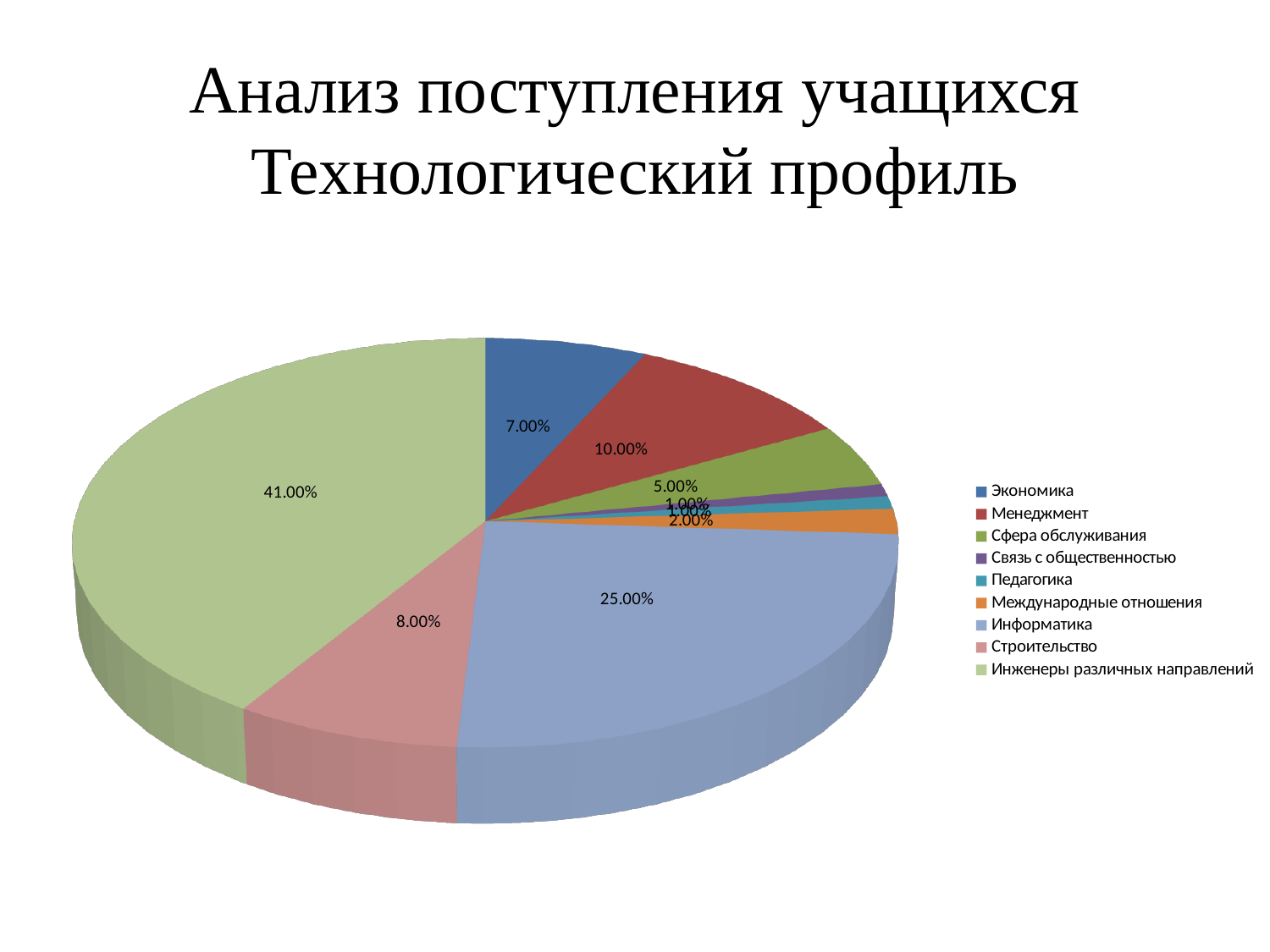
What is the value shown for Менеджмент? 10.00% What is the title of the slide containing the chart? Анализ поступления учащихся Технологический профиль Which category has the largest slice of the pie? Инженеры различных направлений What kind of chart is shown on the slide? Pie chart What is the value for Строительство? 8.00% What is the difference between the shares of Инженеры различных направлений and Информатика? 16.00% What share is shown for Инженеры различных направлений? 41.00% What percentage is labelled for Информатика? 25.00% Which is larger, the share for Менеджмент or the share for Строительство? Менеджмент What is the value for Сфера обслуживания? 5.00% What share of the pie does Экономика have? 7.00% How many categories does the pie chart contain? 9